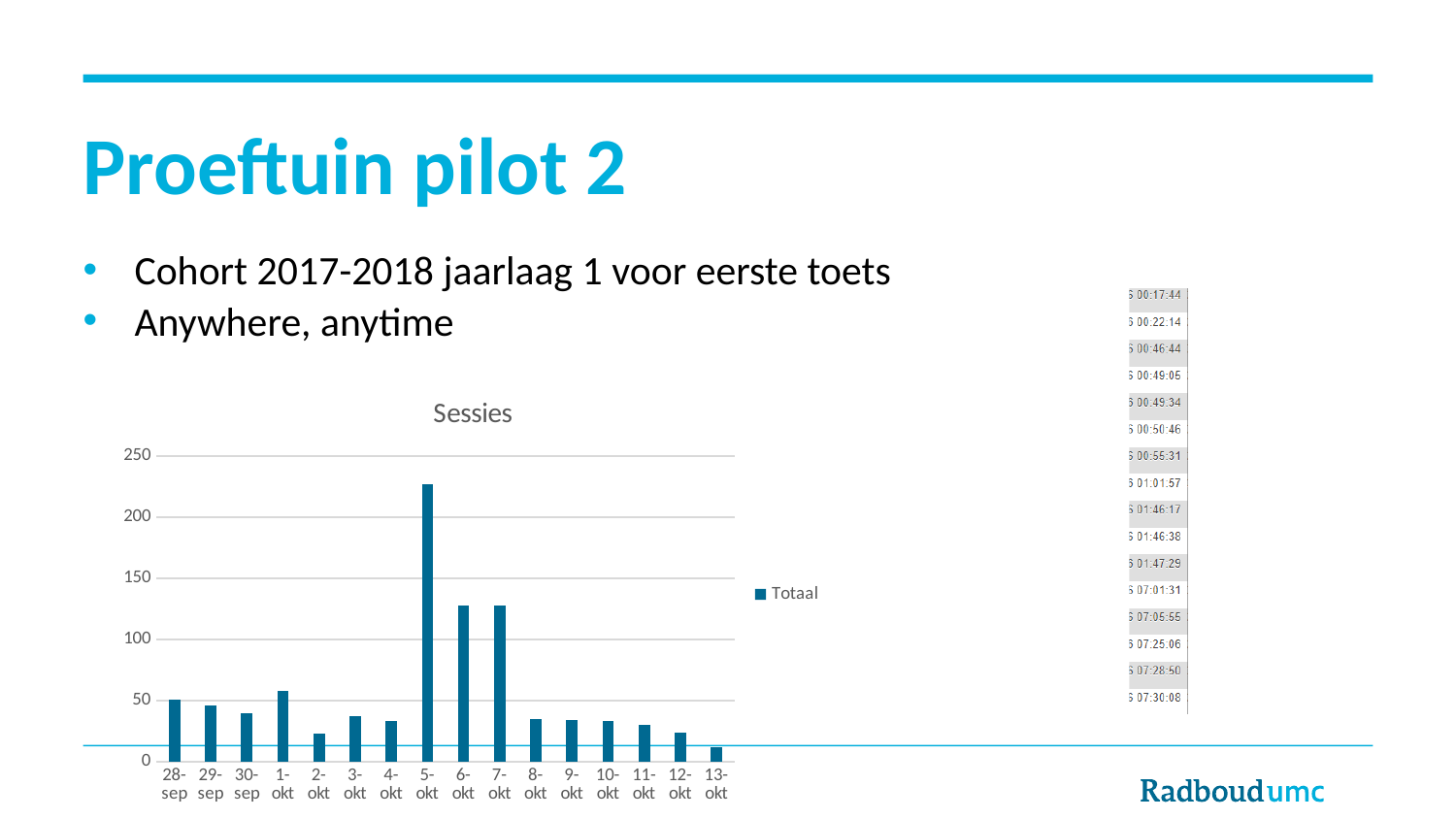
How many dates are shown on the x axis of the chart? 16 What is the title of the chart? Sessies Which date has the highest number of sessions? 5-okt Which date has the lowest number of sessions? 13-okt What kind of chart is shown on the slide? bar chart How many series does the chart legend list? 1 Is the value for 6-okt greater or less than 100? greater Is the value for 2-okt greater or less than 50? less Is the value for 5-okt greater or less than 200? greater What is the name of the series shown in the chart legend? Totaal Which has more sessions, 1-okt or 2-okt? 1-okt Which has more sessions, 5-okt or 6-okt? 5-okt